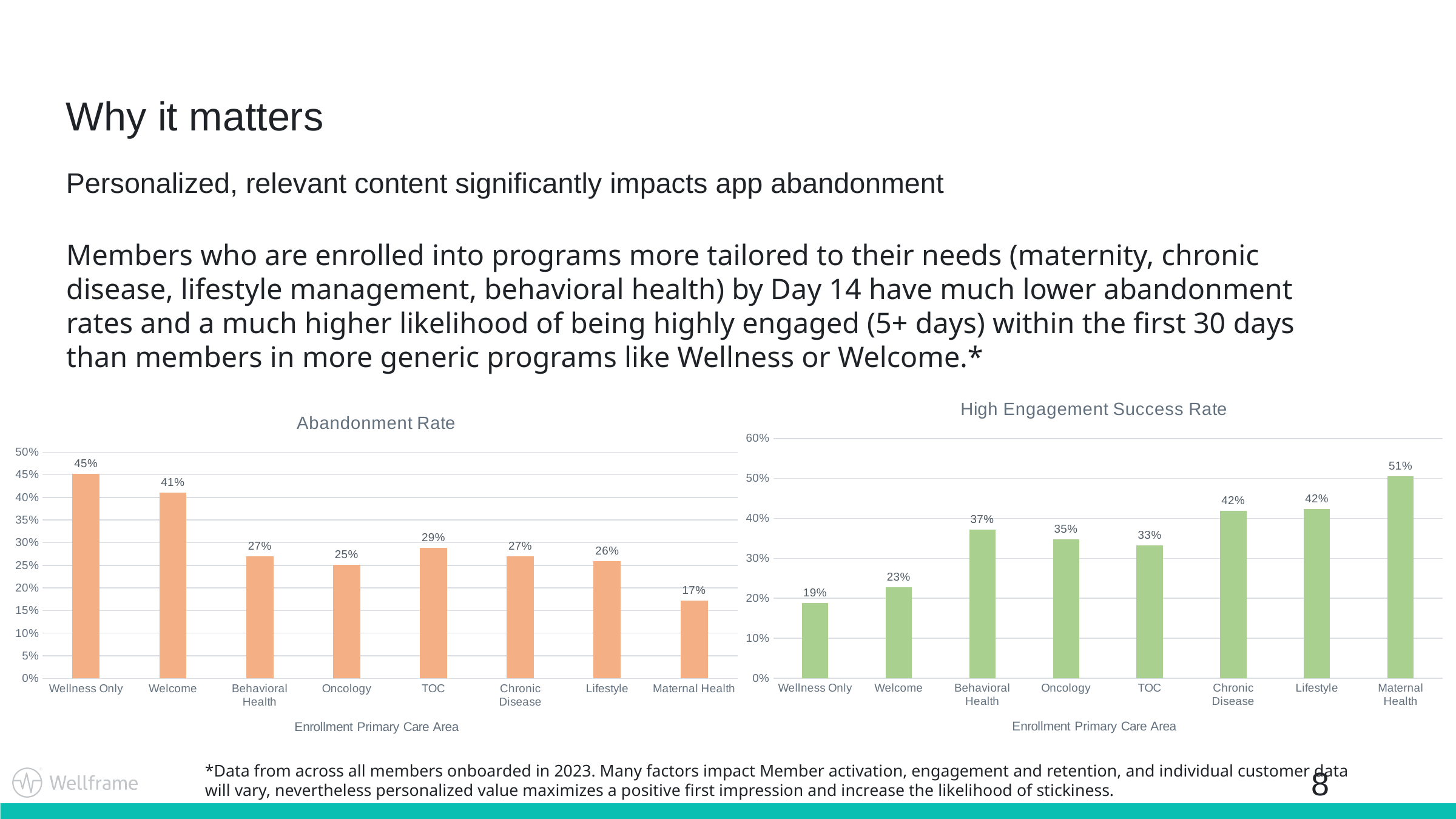
What is the x-axis title of the Abandonment Rate chart? Enrollment Primary Care Area In the High Engagement Success Rate chart, what is the difference between Behavioral Health and Welcome? 14% In the Abandonment Rate chart, which is larger, Welcome or Oncology? Welcome In the Abandonment Rate chart, what is the difference between Wellness Only and Maternal Health? 28% What kind of chart is the High Engagement Success Rate chart? Bar chart In the Abandonment Rate chart, what is the value for Wellness Only? 45% In the High Engagement Success Rate chart, what is the value for TOC? 33% In the High Engagement Success Rate chart, what is the value for Maternal Health? 51% How many categories are shown in the Abandonment Rate chart? 8 In the Abandonment Rate chart, which category has the lowest value? Maternal Health In the High Engagement Success Rate chart, which category has the highest value? Maternal Health In the High Engagement Success Rate chart, which category has the lowest value? Wellness Only